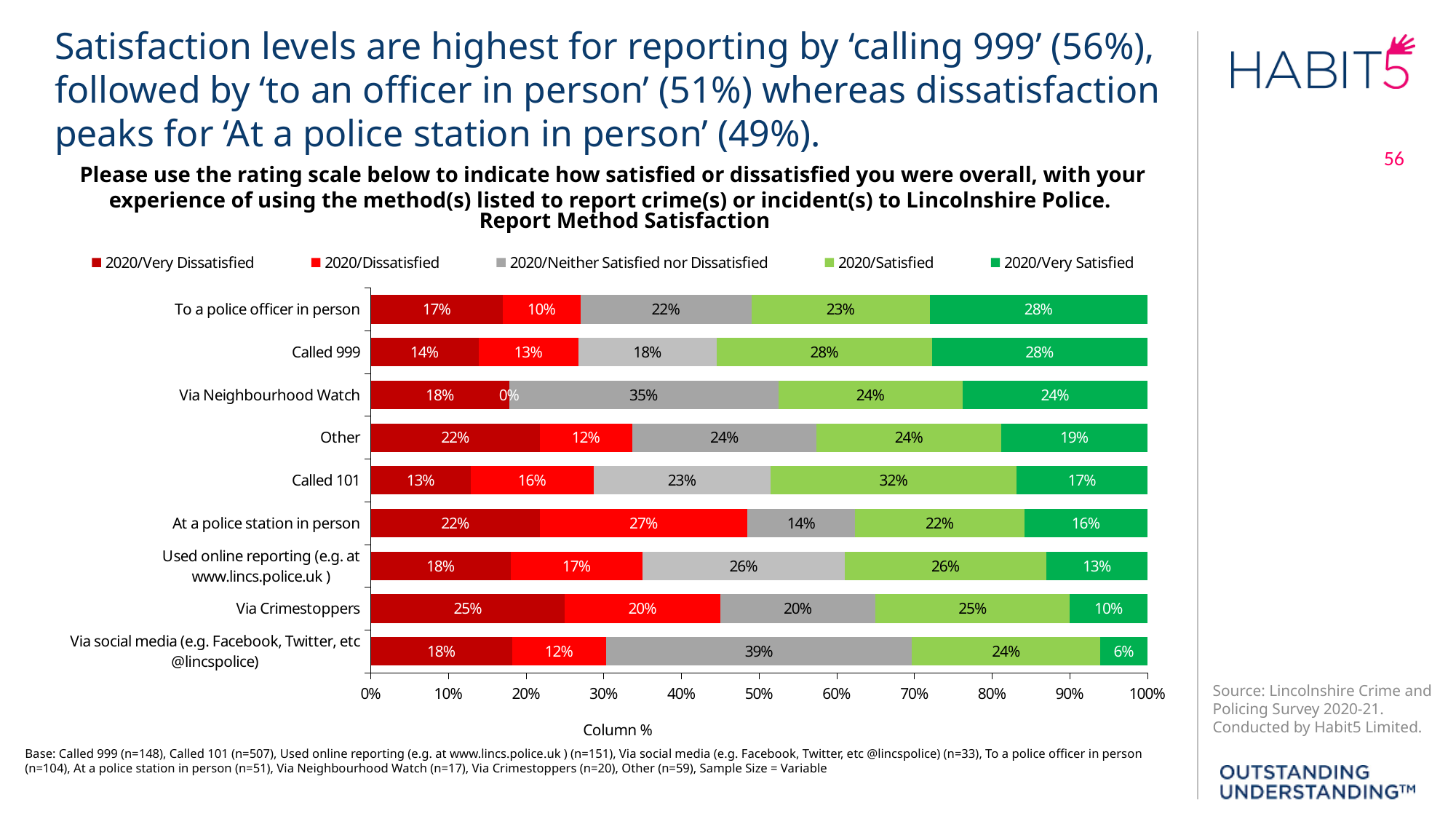
How many series does the legend list? 5 What is the 2020/Neither Satisfied nor Dissatisfied value for 'Via social media (e.g. Facebook, Twitter, etc @lincspolice)'? 39% Which report method has the highest 2020/Satisfied value? Called 101 What is the 2020/Dissatisfied value for 'At a police station in person'? 27% What kind of chart is shown on the slide? stacked bar chart Which report method has the lowest 2020/Very Satisfied value? Via social media (e.g. Facebook, Twitter, etc @lincspolice) How many report methods (categories) are plotted in the chart? 9 What is the difference between the 2020/Very Satisfied values for 'To a police officer in person' and 'Via Crimestoppers'? 18% What is the 2020/Very Satisfied value for 'Called 999'? 28% Which is larger: the 2020/Neither Satisfied nor Dissatisfied value for 'Via Neighbourhood Watch' or for 'Called 999'? Via Neighbourhood Watch Which report method has the highest 2020/Very Dissatisfied value? Via Crimestoppers What is the combined total of the 2020/Very Dissatisfied and 2020/Dissatisfied values for 'At a police station in person'? 49%